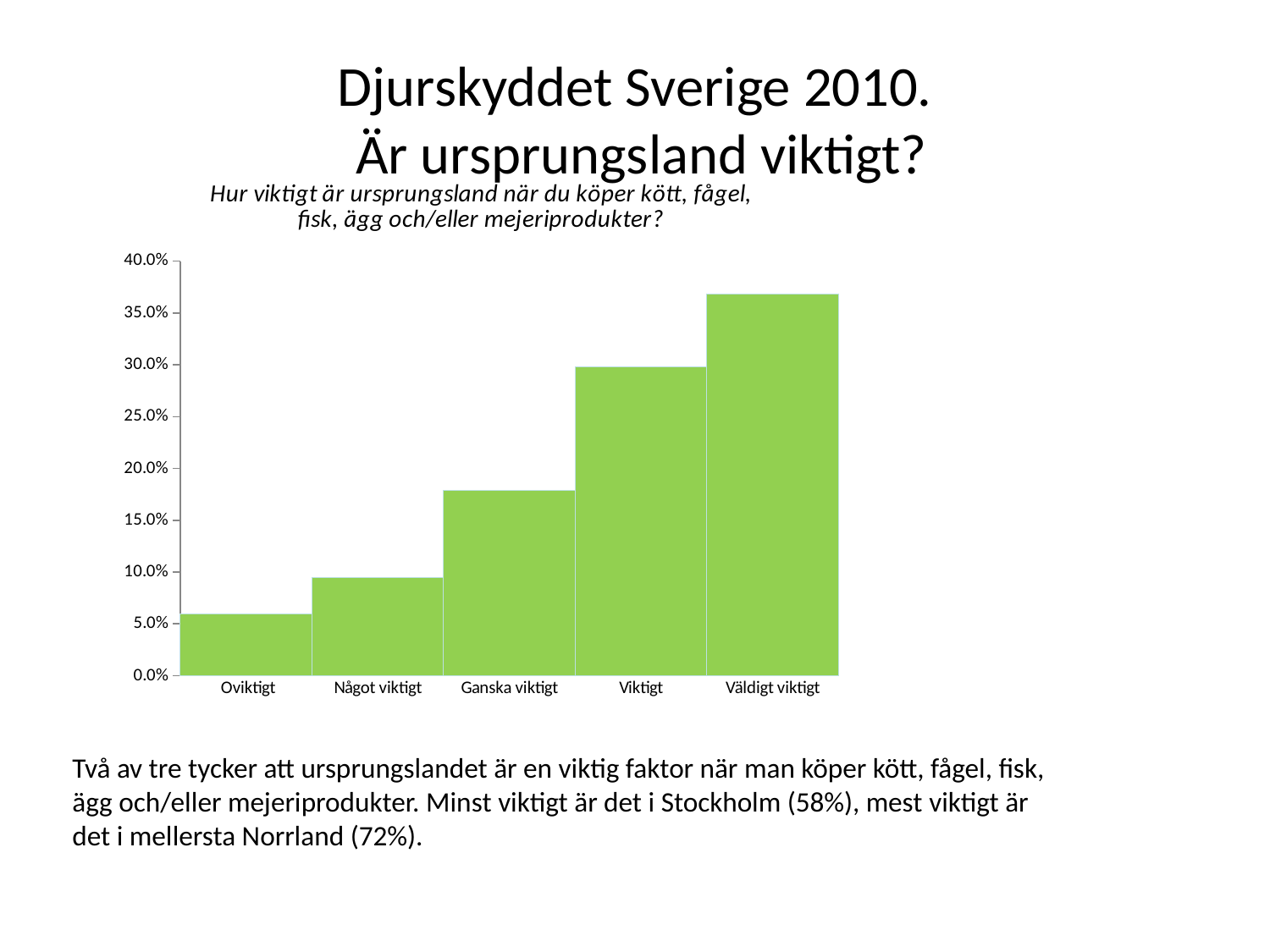
Which category has the highest value in the chart? Väldigt viktigt Which is larger, the value for Viktigt or the value for Ganska viktigt? Viktigt Do the values rise or fall from left to right along the x axis? rise Is the value for Väldigt viktigt greater or less than 35.0%? greater How many categories are shown on the x axis of the chart? 5 What kind of chart is shown on the slide? bar chart What is the title of the chart? Hur viktigt är ursprungsland när du köper kött, fågel, fisk, ägg och/eller mejeriprodukter? Is the value for Ganska viktigt greater or less than 15.0%? greater Is the value for Oviktigt greater or less than 10.0%? less Which category has the lowest value in the chart? Oviktigt